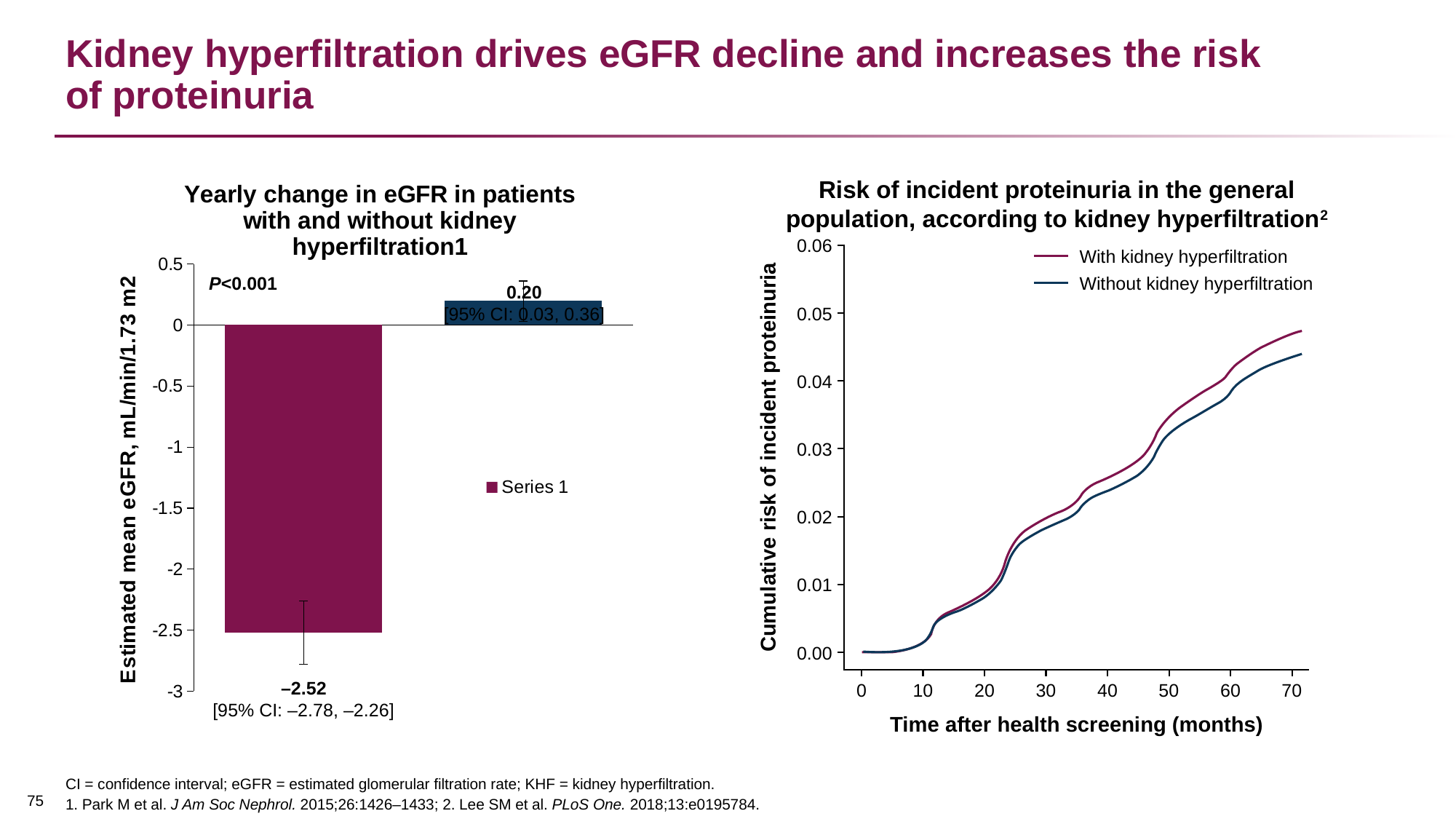
On the left chart (Yearly change in eGFR), what value is printed on the navy bar? 0.20 On the right chart (Risk of incident proteinuria), at 70 months, which line is higher: with kidney hyperfiltration or without kidney hyperfiltration? With kidney hyperfiltration On the right chart (Risk of incident proteinuria), do the lines rise or fall as time after health screening increases? Rise On the right chart (Risk of incident proteinuria), is the value for the 'With kidney hyperfiltration' line at 70 months greater or less than 0.04? greater On the left chart (Yearly change in eGFR), what value is printed on the maroon bar? –2.52 What kind of chart is the left chart (Yearly change in eGFR)? Bar chart What kind of chart is the right chart (Risk of incident proteinuria)? Line chart On the left chart (Yearly change in eGFR), what 95% confidence interval is printed below the maroon bar? [95% CI: –2.78, –2.26] On the left chart (Yearly change in eGFR), how many bars are plotted? 2 On the right chart (Risk of incident proteinuria), how many series does the legend list? 2 On the left chart (Yearly change in eGFR), what P value is shown? P<0.001 On the left chart (Yearly change in eGFR), what is the difference between the navy bar value (0.20) and the maroon bar value (–2.52)? 2.72